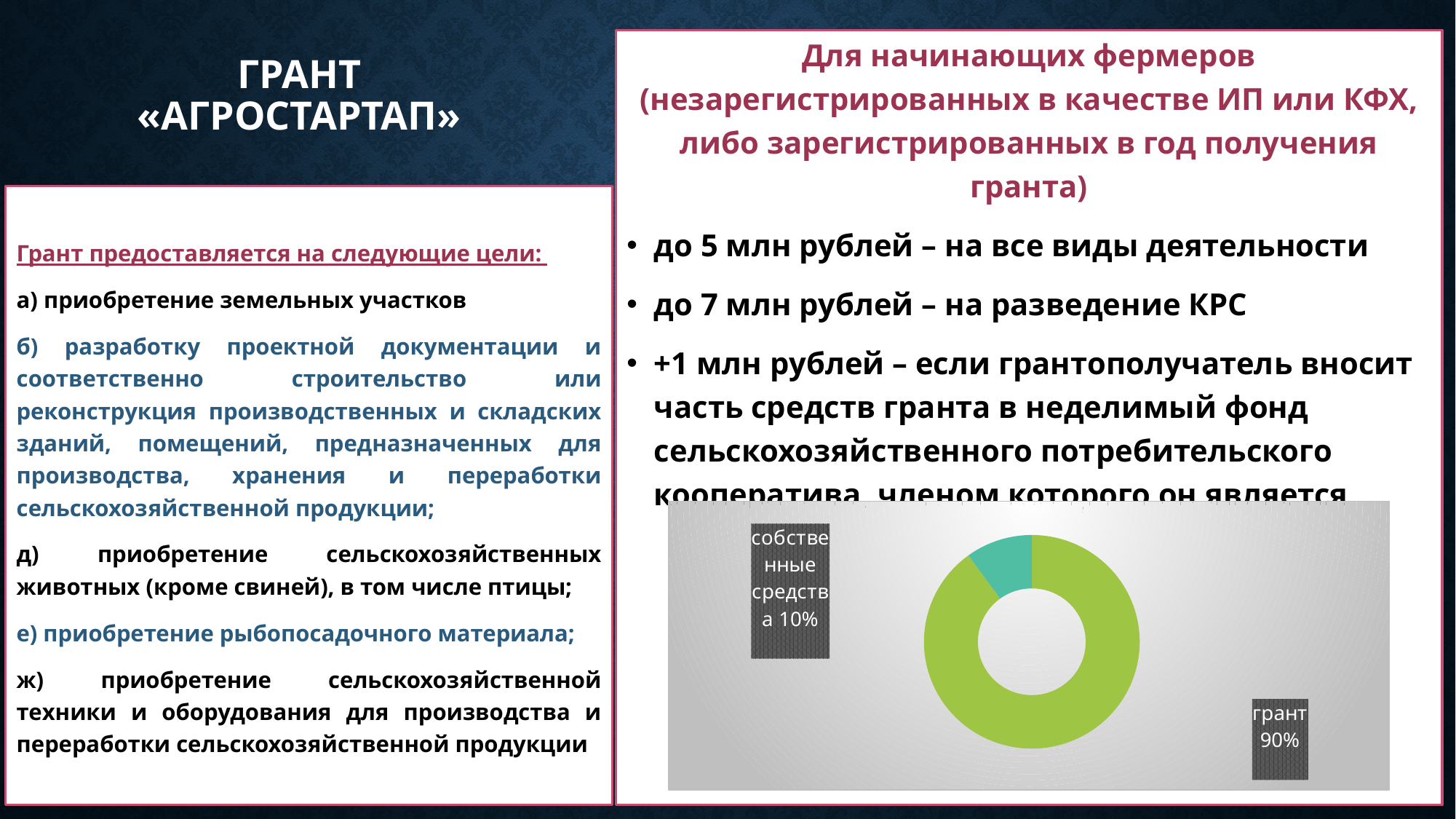
What kind of chart is shown on the slide? doughnut chart Which slice of the doughnut chart is the largest? грант Which slice of the doughnut chart is the smallest? собственные средства What colour is the "собственные средства" slice in the doughnut chart? teal Which is larger in the doughnut chart: "грант" or "собственные средства"? грант What colour is the "грант" slice in the doughnut chart? green What is the difference between the "грант" share and the "собственные средства" share in the doughnut chart? 80% What share of the doughnut chart does "грант" represent? 90% How many slices does the doughnut chart have? 2 What share of the doughnut chart does "собственные средства" represent? 10%